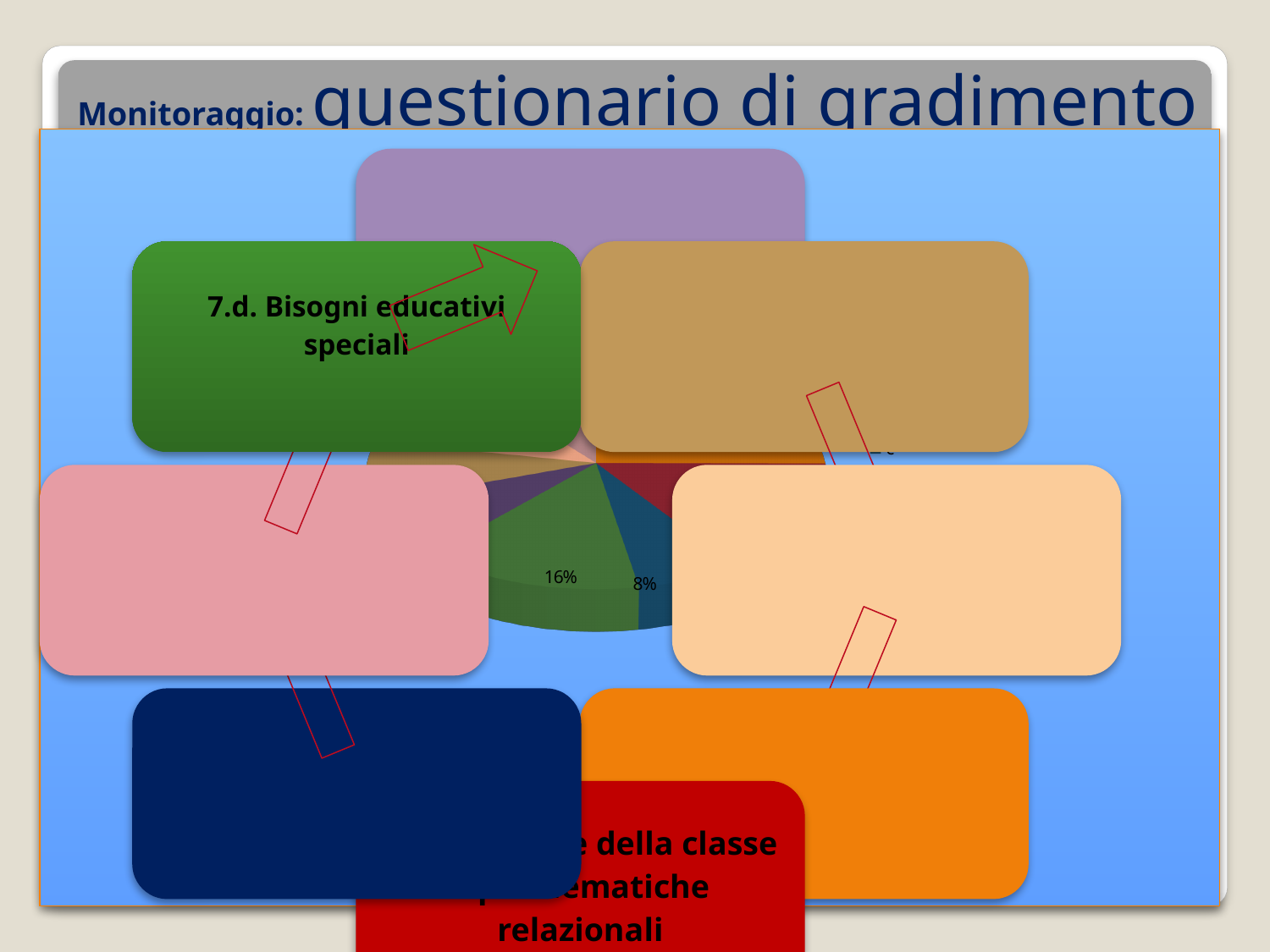
What kind of chart is partially visible on the slide? pie chart Is the pie chart drawn in 3D or flat 2D? 3D What is the difference between the two visible percentage labels on the pie chart, 16% and 8%? 8% What percentage label is printed on the green slice of the pie chart? 16% What percentage label is printed on the dark teal slice of the pie chart? 8% Which is larger, the slice labelled 16% or the slice labelled 8%? the slice labelled 16%